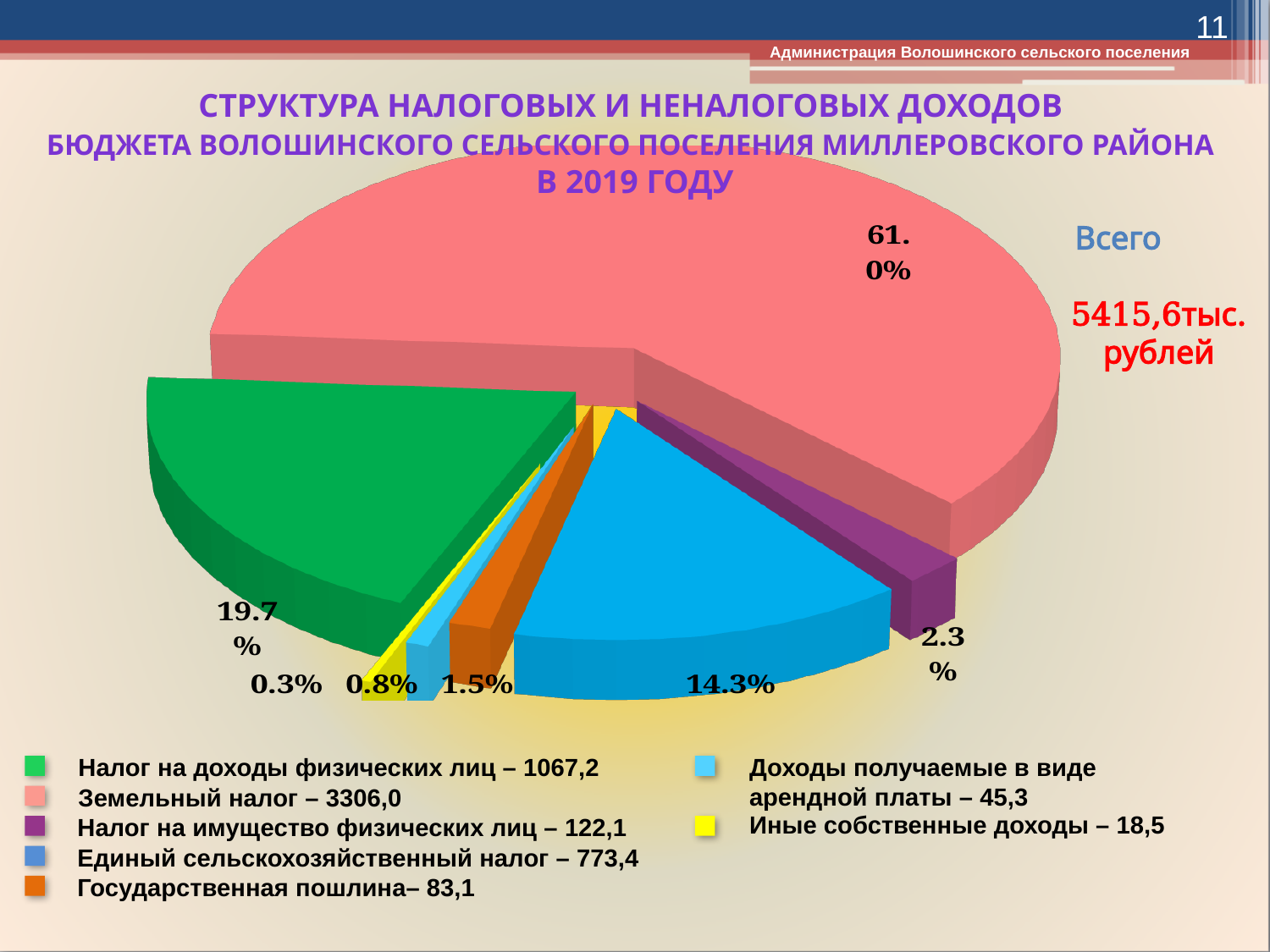
Which category has the smallest share of the pie? Иные собственные доходы What share of the pie does Единый сельскохозяйственный налог account for? 14.3% What share of the pie does Земельный налог account for? 61.0% What kind of chart is shown on the slide? pie chart Which is larger: Налог на доходы физических лиц or Единый сельскохозяйственный налог? Налог на доходы физических лиц What value is given in the legend for Государственная пошлина? 83,1 How many categories (slices) does the pie chart have? 7 Which category has the largest share of the pie? Земельный налог What value is given in the legend for Единый сельскохозяйственный налог? 773,4 What total (Всего) is shown next to the pie chart? 5415,6 тыс. рублей What colour is the slice for Земельный налог? pink What is the difference between the legend values for Земельный налог and Налог на доходы физических лиц? 2238,8